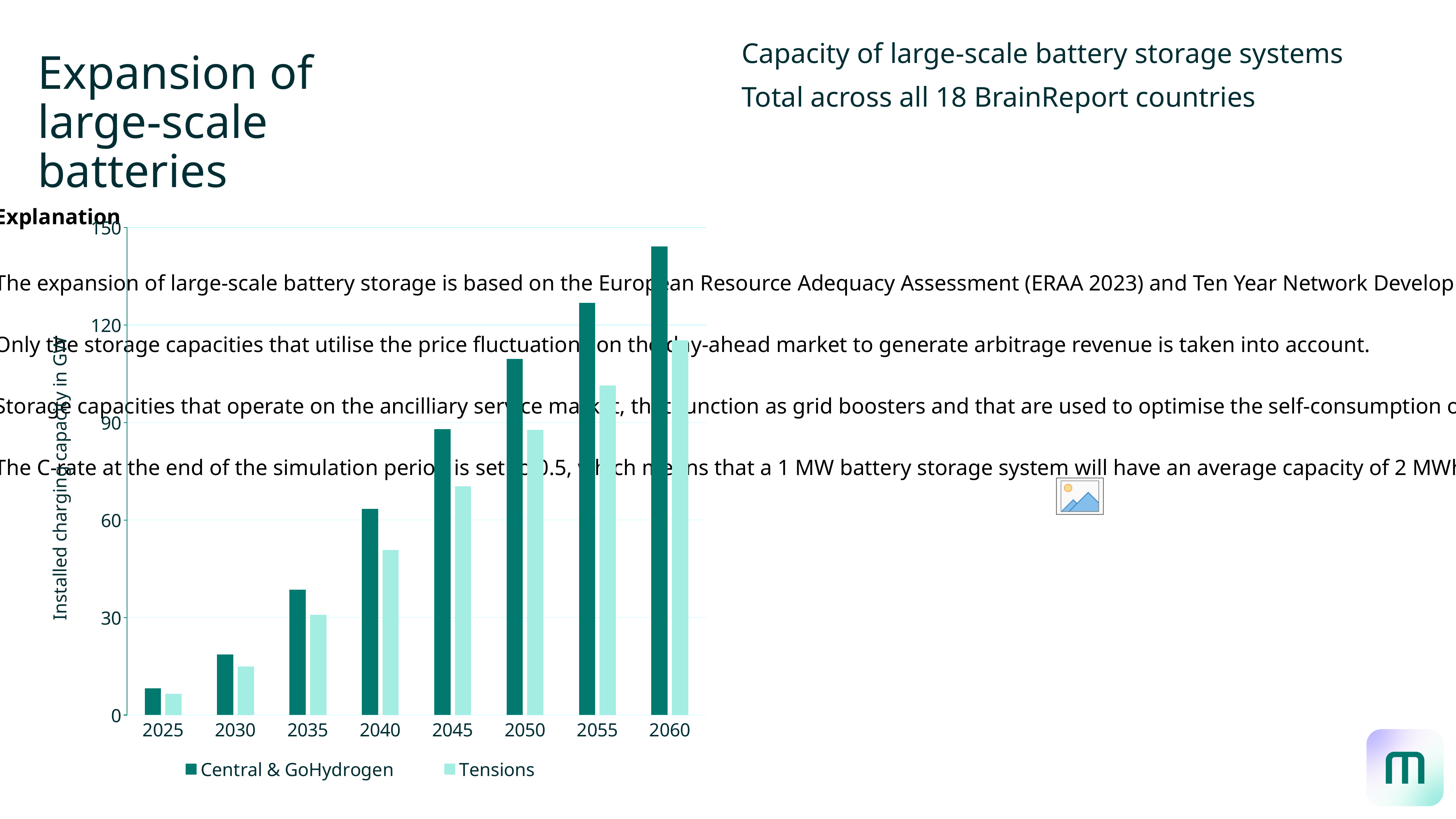
Is the value for Central & GoHydrogen in 2060 greater or less than 120? greater Is the value for Tensions in 2040 greater or less than 60? less Do the values for the Tensions series rise or fall from 2025 to 2060? rise Which year has the highest value for the Central & GoHydrogen series? 2060 What is the label of the chart's vertical axis? Installed charging capacity in GW How many years are shown on the x axis of the chart? 8 Is the value for Tensions in 2025 greater or less than 30? less What kind of chart is shown on the slide? bar chart How many series does the chart legend list? 2 Which year has the lowest value for the Tensions series? 2025 In 2050, which series has the larger value, Central & GoHydrogen or Tensions? Central & GoHydrogen